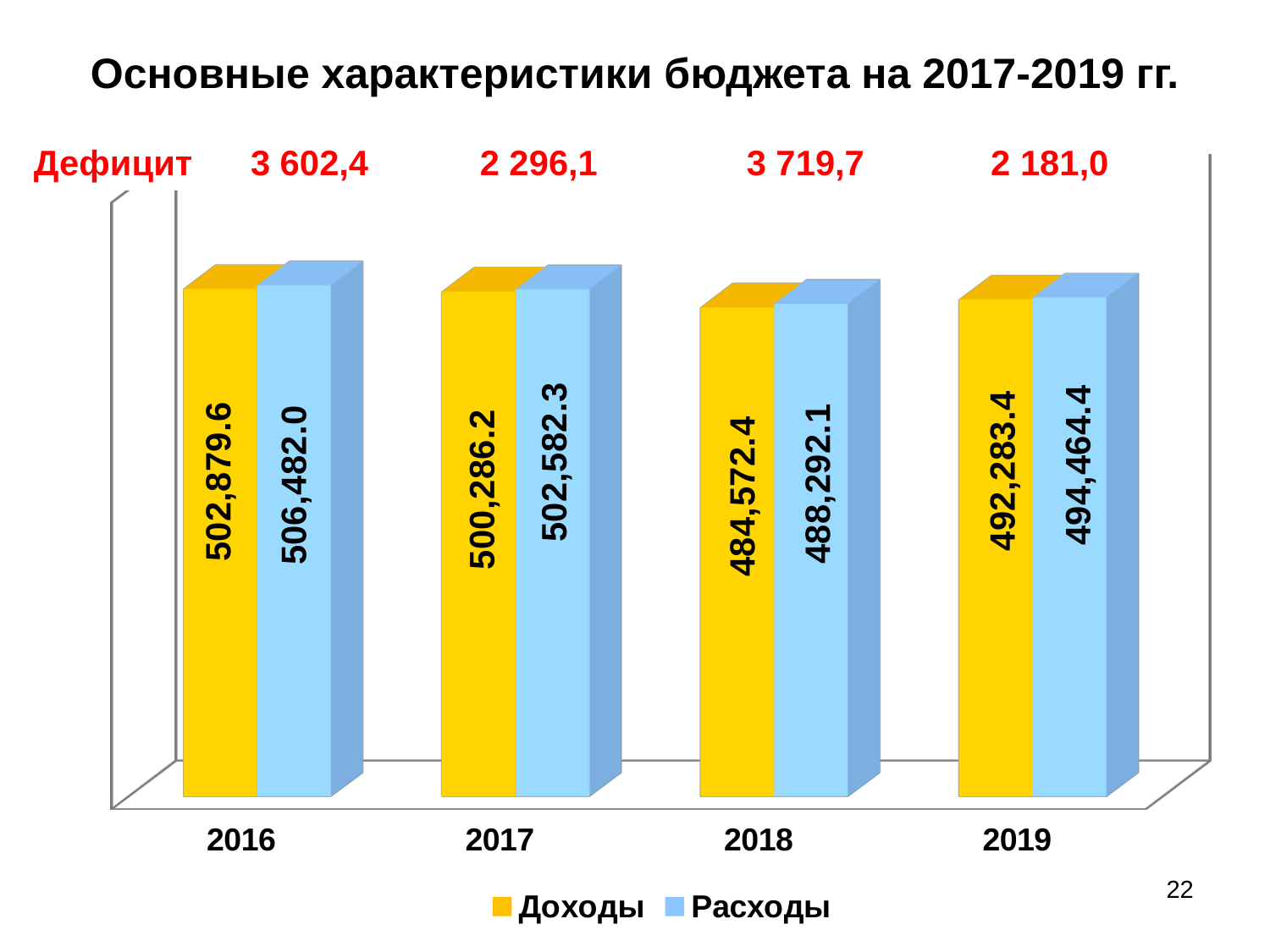
In which year is Доходы the lowest? 2018 How many years are shown on the x axis? 4 What is the Дефицит value shown for 2017? 2 296,1 What is the value of Доходы for 2016? 502,879.6 In which year is Расходы the highest? 2016 What is the value of Доходы for 2017? 500,286.2 What type of chart is shown on the slide? bar chart How many series does the legend list? 2 What is the difference between Расходы and Доходы in 2018? 3,719.7 What is the value of Расходы for 2018? 488,292.1 What is the value of Расходы for 2019? 494,464.4 Which is larger in 2019, Доходы or Расходы? Расходы